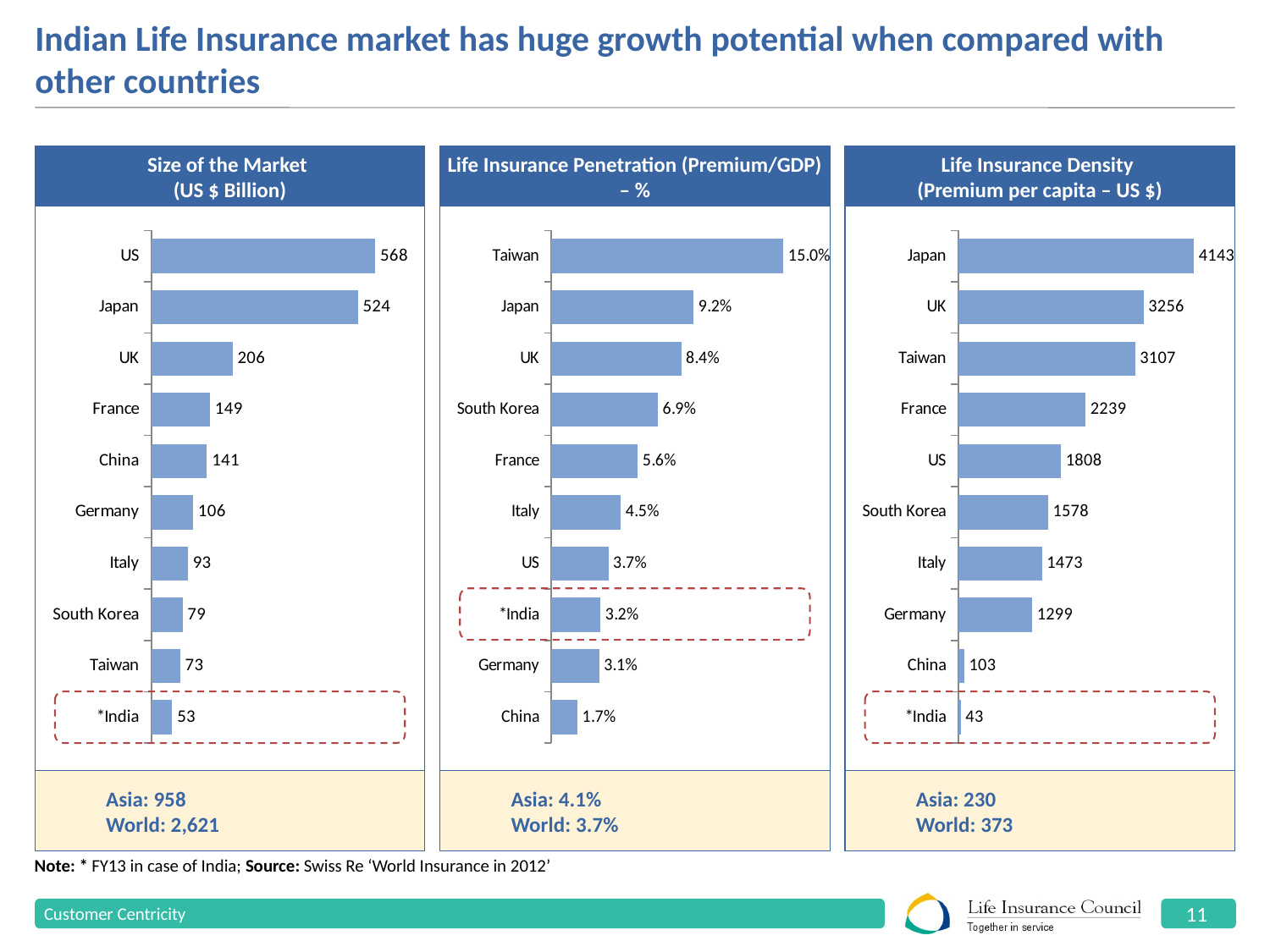
What kind of chart is the 'Life Insurance Density (Premium per capita – US $)' chart? Bar chart In the 'Life Insurance Penetration (Premium/GDP) – %' chart, which country has the highest value? Taiwan How many charts are shown on the slide? 3 In the 'Life Insurance Density (Premium per capita – US $)' chart, what is the value for France? 2239 In the 'Life Insurance Penetration (Premium/GDP) – %' chart, what is the value for *India? 3.2% In the 'Life Insurance Density (Premium per capita – US $)' chart, which country has the lowest value? *India In the 'Size of the Market (US $ Billion)' chart, what is the value for Japan? 524 In the 'Size of the Market (US $ Billion)' chart, which country has the lowest value? *India In the 'Size of the Market (US $ Billion)' chart, what is the difference between the US and the UK? 362 How many countries are shown in the 'Size of the Market (US $ Billion)' chart? 10 In the 'Life Insurance Density (Premium per capita – US $)' chart, what is the difference between Japan and the UK? 887 In the 'Life Insurance Penetration (Premium/GDP) – %' chart, which is larger, Japan or the UK? Japan